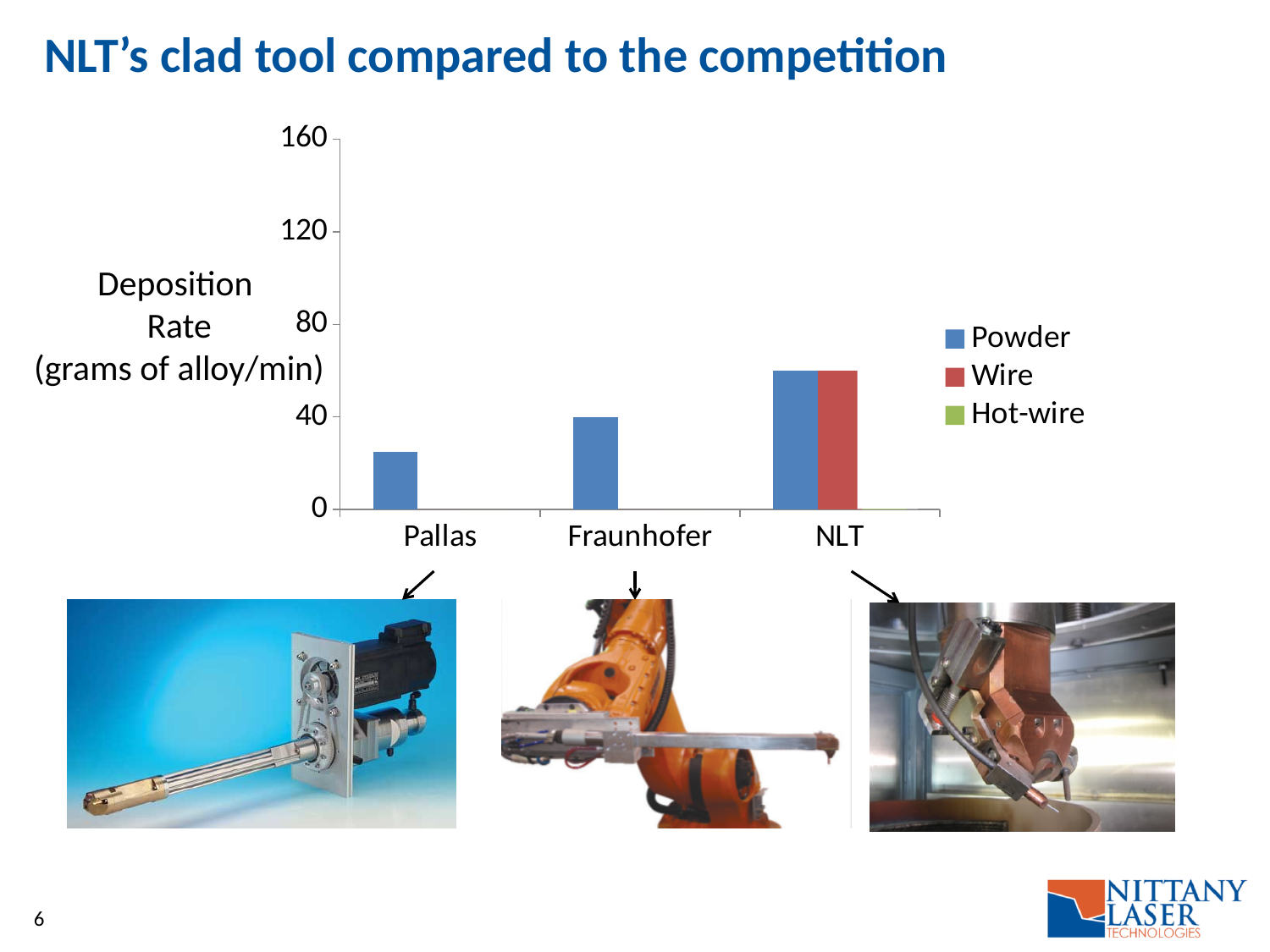
Which has a larger Powder deposition rate, Pallas or Fraunhofer? Fraunhofer Which category is the only one with a visible Wire bar? NLT How many series does the legend list? 3 What kind of chart is shown on the slide? bar chart Which category has the lowest Powder deposition rate? Pallas What is the label on the y axis of the chart? Deposition Rate (grams of alloy/min) Do the Powder values rise or fall from Pallas to NLT along the x axis? rise Is the Powder value for NLT greater or less than 40? greater How many categories are shown on the x axis? 3 Is the Wire value for NLT greater or less than 80? less Is the Powder value for Pallas greater or less than 40? less Which category has the highest Powder deposition rate? NLT